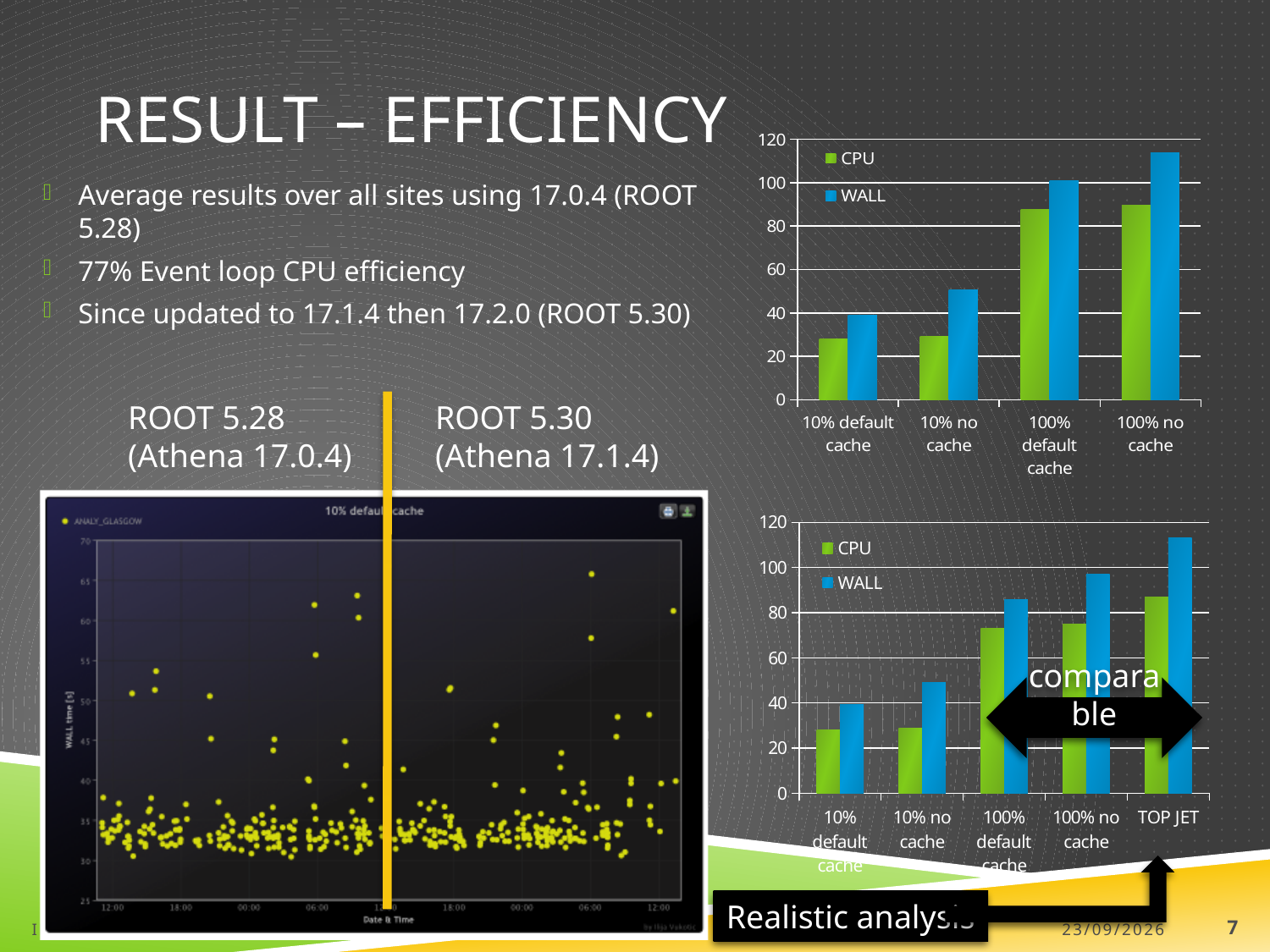
In the bottom-right chart, which category has the highest WALL value? TOP JET In the bottom-right chart, is the CPU value for 100% default cache greater or less than 60? greater In the top-right chart, is the CPU value for 10% default cache greater or less than 40? less In the top-right chart, which category has the highest WALL value? 100% no cache In the top-right chart, which is larger for 10% no cache, CPU or WALL? WALL How many categories are shown on the x axis of the top-right chart? 4 How many categories are shown on the x axis of the bottom-right chart? 5 In the bottom-right chart, is the WALL value for TOP JET greater or less than 100? greater How many series does the legend of the top-right chart list? 2 What are the two legend entries of the bottom-right chart? CPU and WALL What kind of chart is the top-right chart on the slide? bar chart